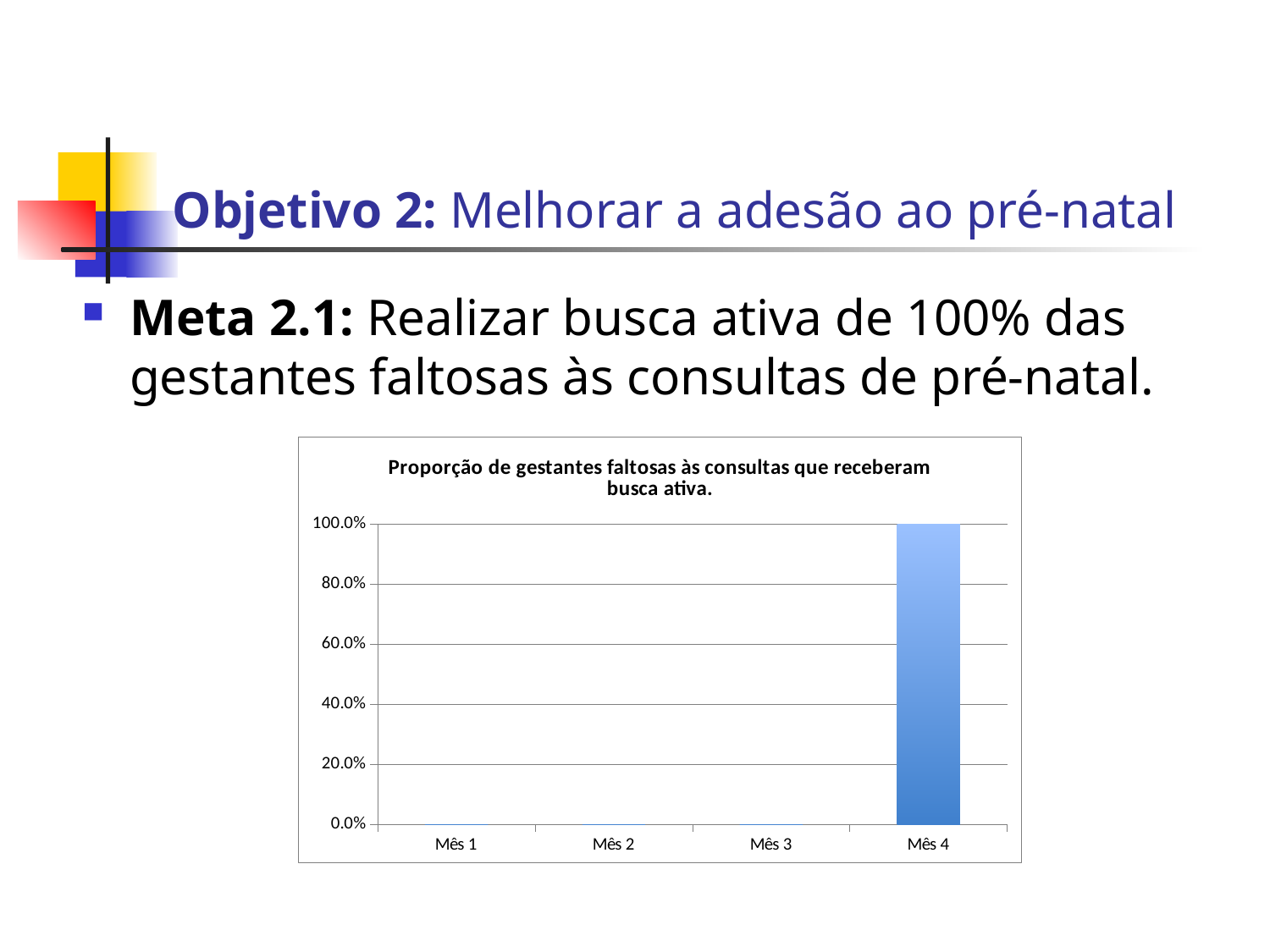
What is the value for Mês 3 in the chart? 0.0% Which is larger, the value for Mês 3 or the value for Mês 4? Mês 4 How many categories are shown on the x axis of the chart? 4 Which month has the highest value in the chart? Mês 4 What is the difference between the values for Mês 4 and Mês 1? 100.0% What is the title of the chart? Proporção de gestantes faltosas às consultas que receberam busca ativa. What is the highest tick value shown on the y axis of the chart? 100.0% Is the value for Mês 2 greater or less than 20.0%? less Is the value for Mês 4 greater or less than 80.0%? greater What is the value for Mês 1 in the chart? 0.0% What kind of chart is shown on the slide? bar chart What is the value for Mês 4 in the chart? 100.0%